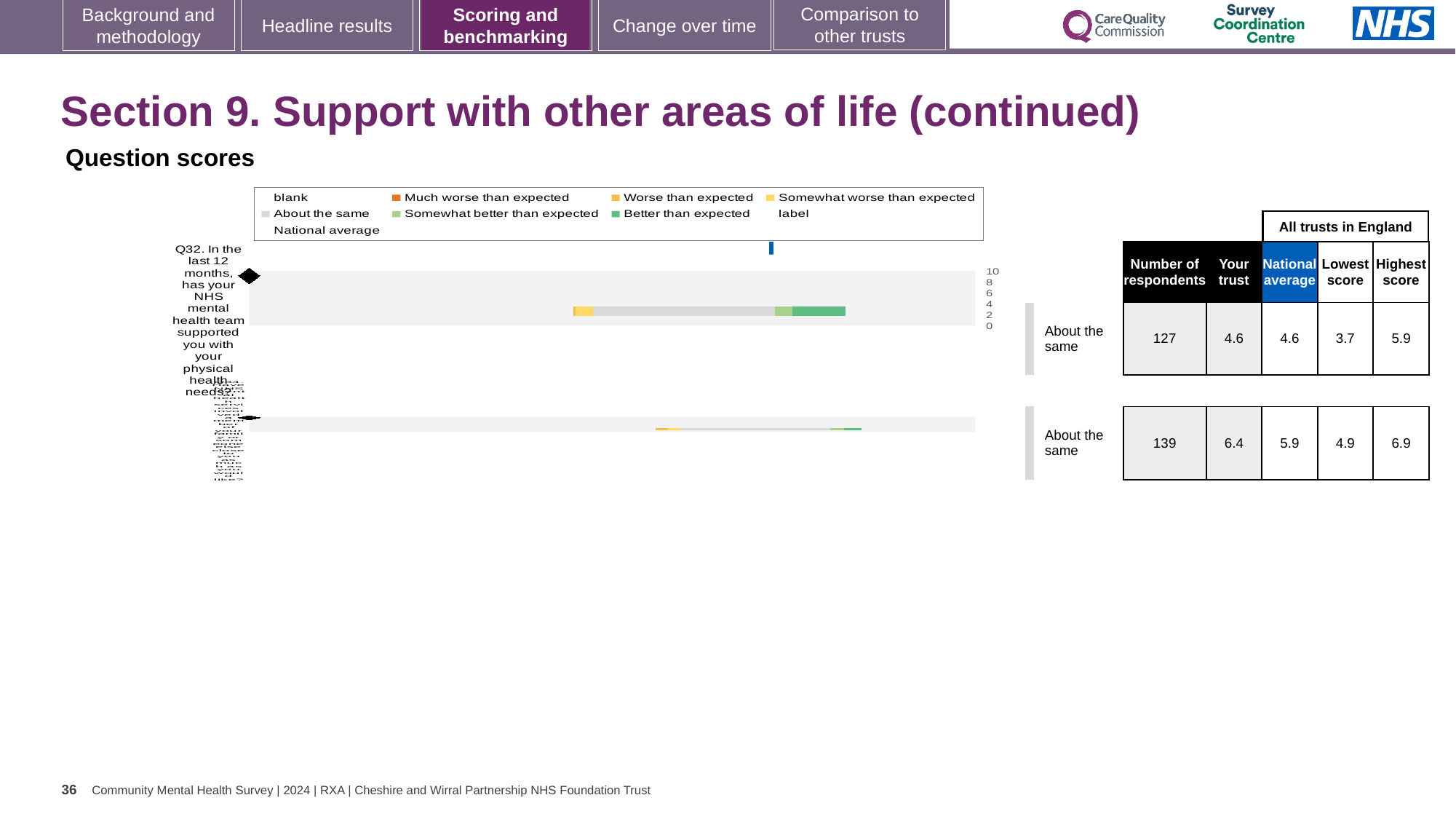
What benchmark category is shown for Q32? About the same Is the trust's score for Q32 higher than, lower than, or the same as the national average? the same What is the highest score among all trusts in England for Q32? 5.9 What is the difference between the highest and lowest trust scores for Q32? 2.2 Is the trust's score for Q32 greater or less than 6? less What type of chart is used to show the question scores on this slide? bar chart How many entries does the chart legend list? 9 What is the national average score for Q32? 4.6 What is the lowest score among all trusts in England for Q32? 3.7 How many respondents answered Q32? 127 What is the 'Your trust' score for Q32 (support with physical health needs)? 4.6 How many question bars are plotted in the chart? 2